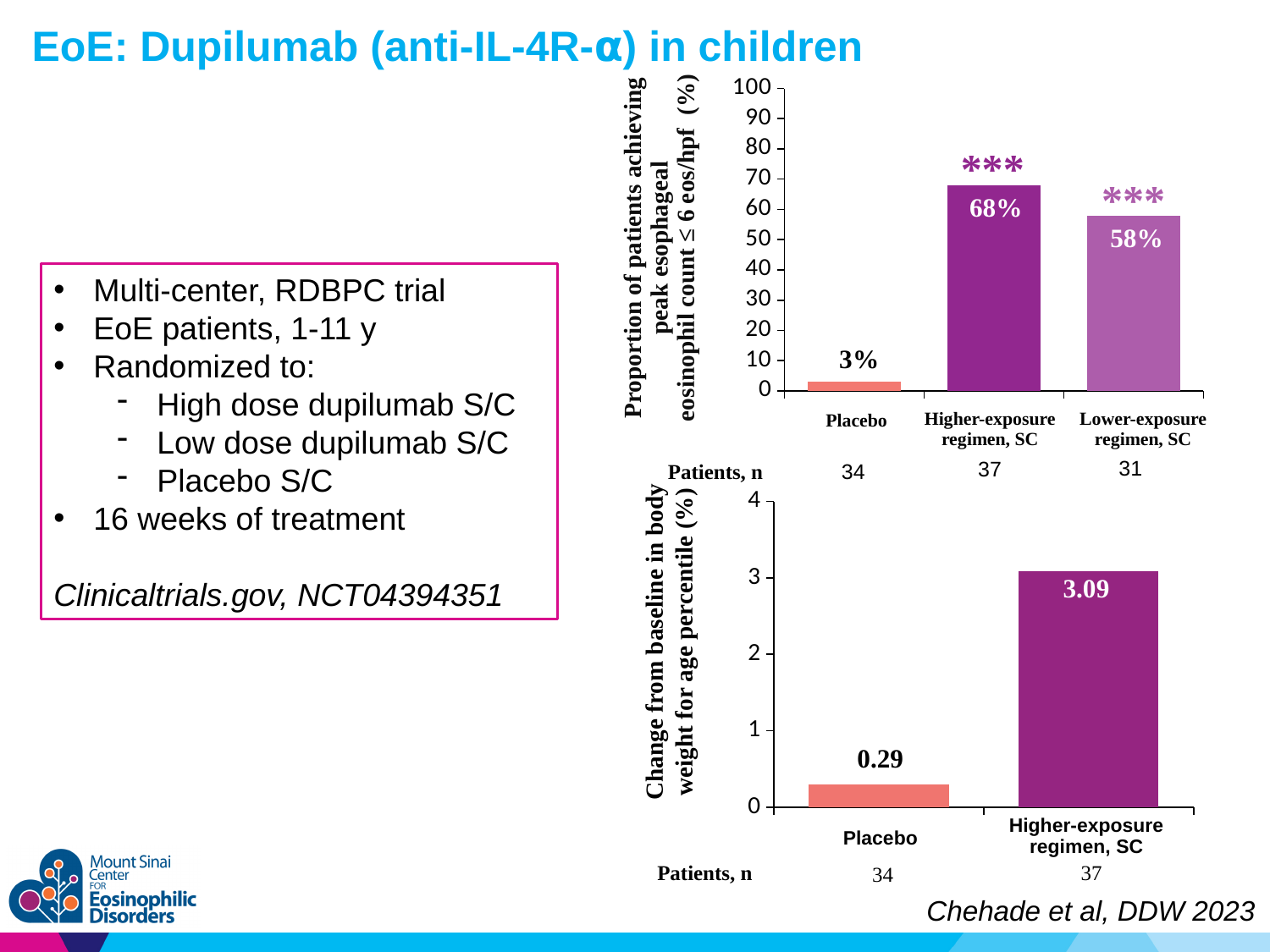
In the bottom chart, which group has the larger change from baseline in body weight for age percentile, Placebo or the higher-exposure regimen? Higher-exposure regimen, SC In the top chart, what is the value for Placebo? 3% In the top chart, what is the value for the lower-exposure regimen, SC? 58% In the top chart, how many groups are plotted? 3 In the bottom chart, what is the value for Placebo? 0.29 In the top chart, which group has the lowest value? Placebo In the top chart, what proportion of patients on the higher-exposure regimen achieved a peak esophageal eosinophil count ≤ 6 eos/hpf? 68% In the top chart, what is the difference between the higher-exposure and lower-exposure regimen values? 10% In the bottom chart, what is the difference between the higher-exposure regimen and Placebo values? 2.80 In the bottom chart, what is the change from baseline in body weight for age percentile for the higher-exposure regimen? 3.09 In the top chart, which group has the highest proportion of patients achieving peak esophageal eosinophil count ≤ 6 eos/hpf? Higher-exposure regimen, SC What kind of chart is the bottom chart? Bar chart